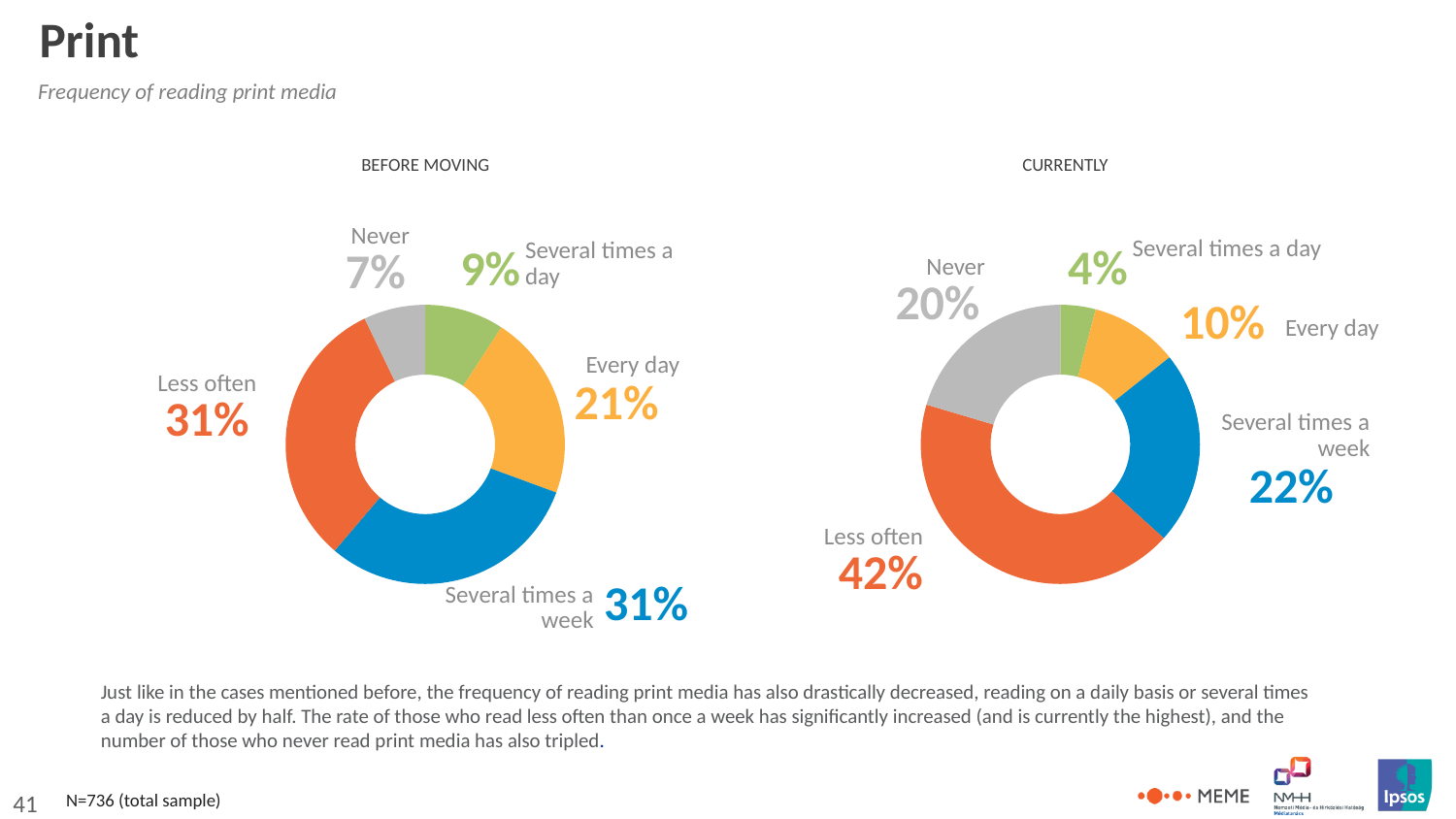
Is the 'Every day' share larger in the BEFORE MOVING chart or in the CURRENTLY chart? BEFORE MOVING In the BEFORE MOVING chart, which category has the lowest share? Never In the BEFORE MOVING chart, what percentage of respondents read print media every day? 21% What type of chart is used for the CURRENTLY data? Donut (pie) chart In the CURRENTLY chart, what is the value for 'Several times a week'? 22% In the CURRENTLY chart, what percentage of respondents never read print media? 20% How many categories does the BEFORE MOVING chart show? 5 In the CURRENTLY chart, which category has the lowest share? Several times a day In the BEFORE MOVING chart, what is the value for 'Several times a day'? 9% What is the difference between the 'Less often' value in the CURRENTLY chart and the 'Less often' value in the BEFORE MOVING chart? 11 percentage points What colour represents the 'Less often' category in both charts? Orange In the CURRENTLY chart, which category has the highest share? Less often